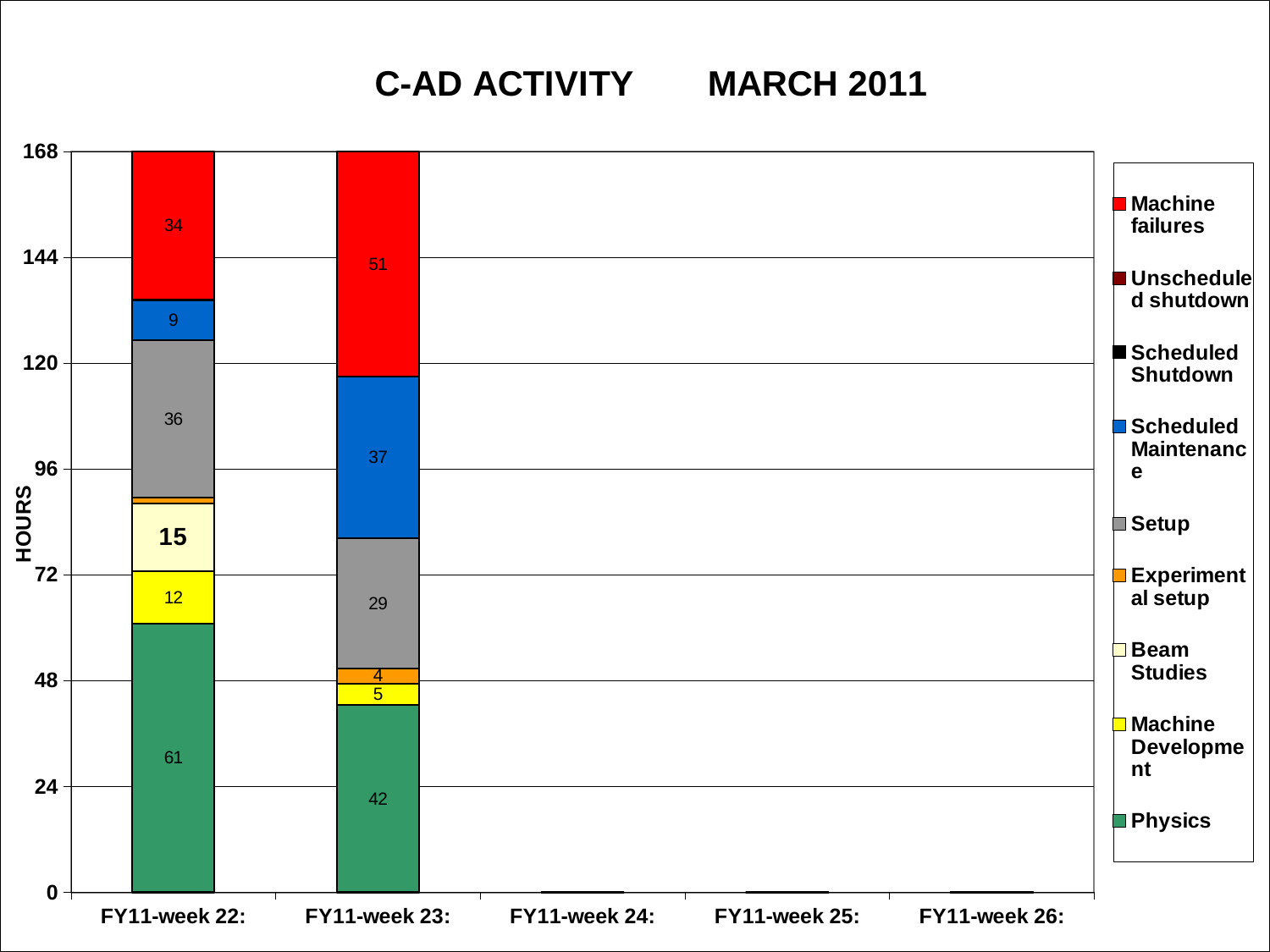
Which week has the larger Machine failures value, FY11-week 22 or FY11-week 23? FY11-week 23 By how much does the Physics value for FY11-week 22 exceed that for FY11-week 23? 19 How many week categories are shown on the x axis? 5 What is the total of the stacked bar for FY11-week 23? 168 What is the Scheduled Maintenance value for FY11-week 23? 37 How many series does the legend list? 9 Which series has the largest value in the FY11-week 22 bar? Physics What is the Setup value for FY11-week 22? 36 What is the Machine failures value for FY11-week 23? 51 What is the Beam Studies value for FY11-week 22? 15 How many hours of Physics are shown for FY11-week 22? 61 What kind of chart is shown on the slide? Stacked bar chart